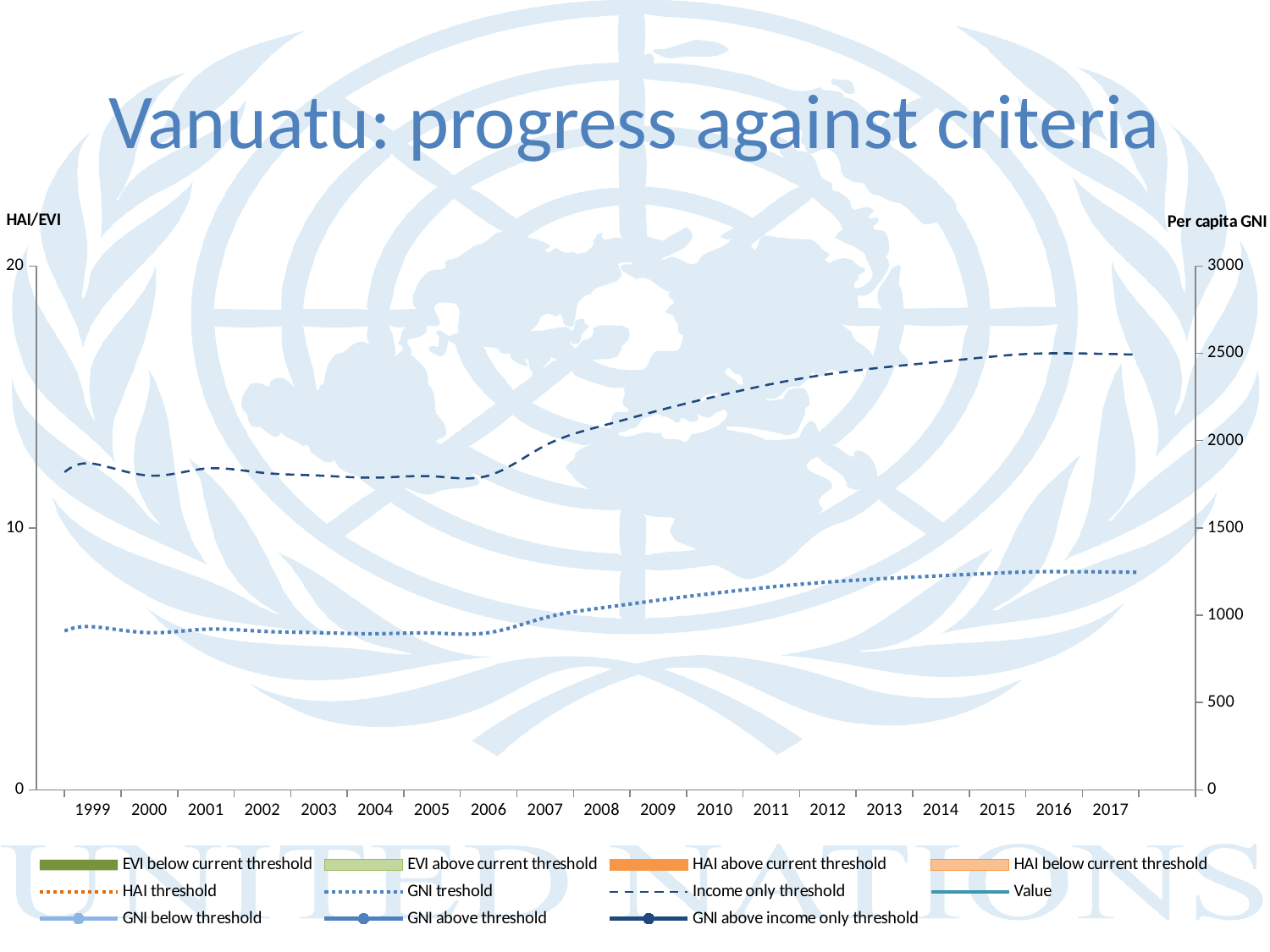
How many entries does the chart's legend list? 11 In 2017, which line is higher: the Income only threshold or the GNI treshold? Income only threshold What is the label of the right-hand vertical axis? Per capita GNI What kind of chart is shown on the slide? line chart Is the value of the Income only threshold line in 1999 greater or less than 2000? less Is the value of the GNI treshold line in 1999 greater or less than 1000? less Does the Income only threshold line rise or fall from 1999 to 2017? rise Is the value of the GNI treshold line in 2017 greater or less than 1000? greater How many years are shown along the x axis of the chart? 19 What is the title of the chart? Vanuatu: progress against criteria